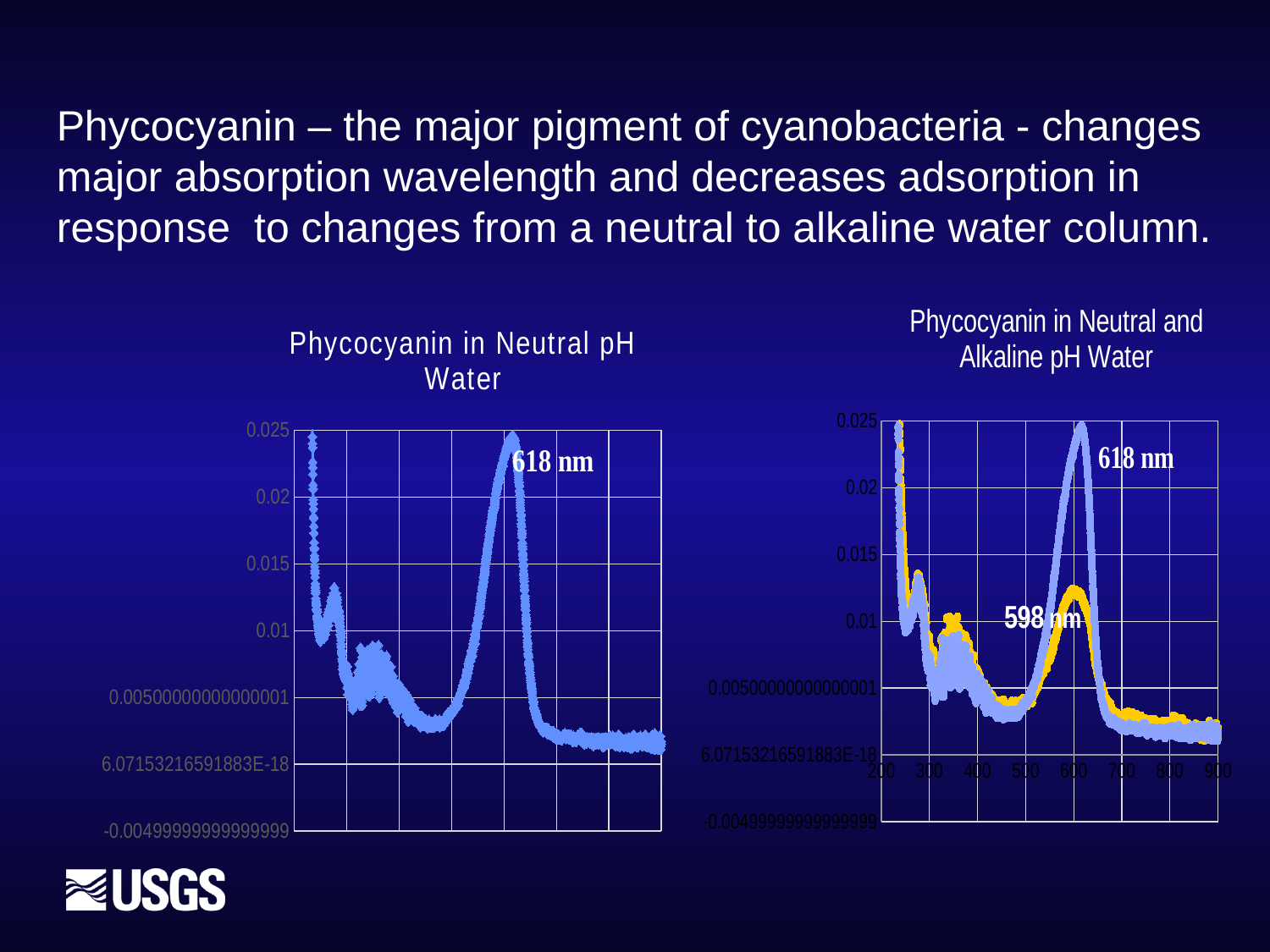
In the right chart, 'Phycocyanin in Neutral and Alkaline pH Water', what is the highest tick shown on the x axis? 900 What kind of chart is the left chart, 'Phycocyanin in Neutral pH Water'? line chart What is the title of the right chart? Phycocyanin in Neutral and Alkaline pH Water In the right chart, 'Phycocyanin in Neutral and Alkaline pH Water', how many lines are plotted? 2 In the right chart, 'Phycocyanin in Neutral and Alkaline pH Water', do the values rise or fall between 618 and 900 on the x axis? fall In the right chart, 'Phycocyanin in Neutral and Alkaline pH Water', which peak is higher, the one labelled 618 nm or the one labelled 598 nm? 618 nm In the right chart, 'Phycocyanin in Neutral and Alkaline pH Water', is the value at the 598 nm peak greater or less than 0.015? less In the left chart, 'Phycocyanin in Neutral pH Water', what wavelength is labelled at the main absorption peak? 618 nm In the right chart, 'Phycocyanin in Neutral and Alkaline pH Water', is the value at 800 on the x axis greater or less than 0.005? less In the right chart, 'Phycocyanin in Neutral and Alkaline pH Water', what wavelength is labelled at the lower, yellow peak? 598 nm In the left chart, 'Phycocyanin in Neutral pH Water', is the value at the 618 nm peak greater or less than 0.02? greater